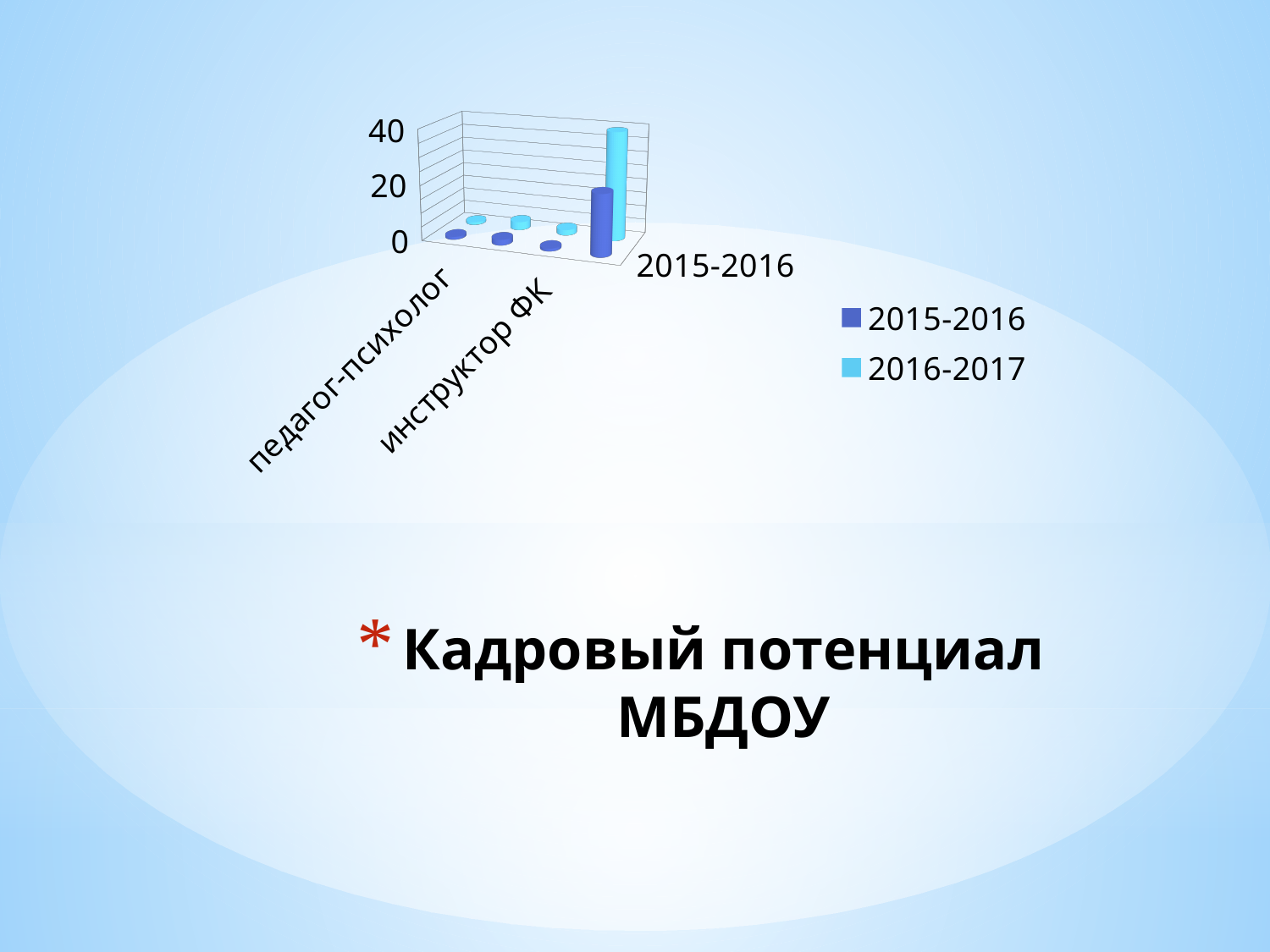
How many series does the chart legend list? 2 Is the value for педагог-психолог in 2016-2017 greater or less than 20? less What are the two series named in the chart legend? 2015-2016 and 2016-2017 What kind of chart is shown on the slide? bar chart Is the value for педагог-психолог in 2015-2016 greater or less than 20? less Which series is drawn in light blue in the chart? 2016-2017 What is the highest tick value shown on the chart's vertical axis? 40 Is the value for инструктор ФК in 2015-2016 greater or less than 20? less